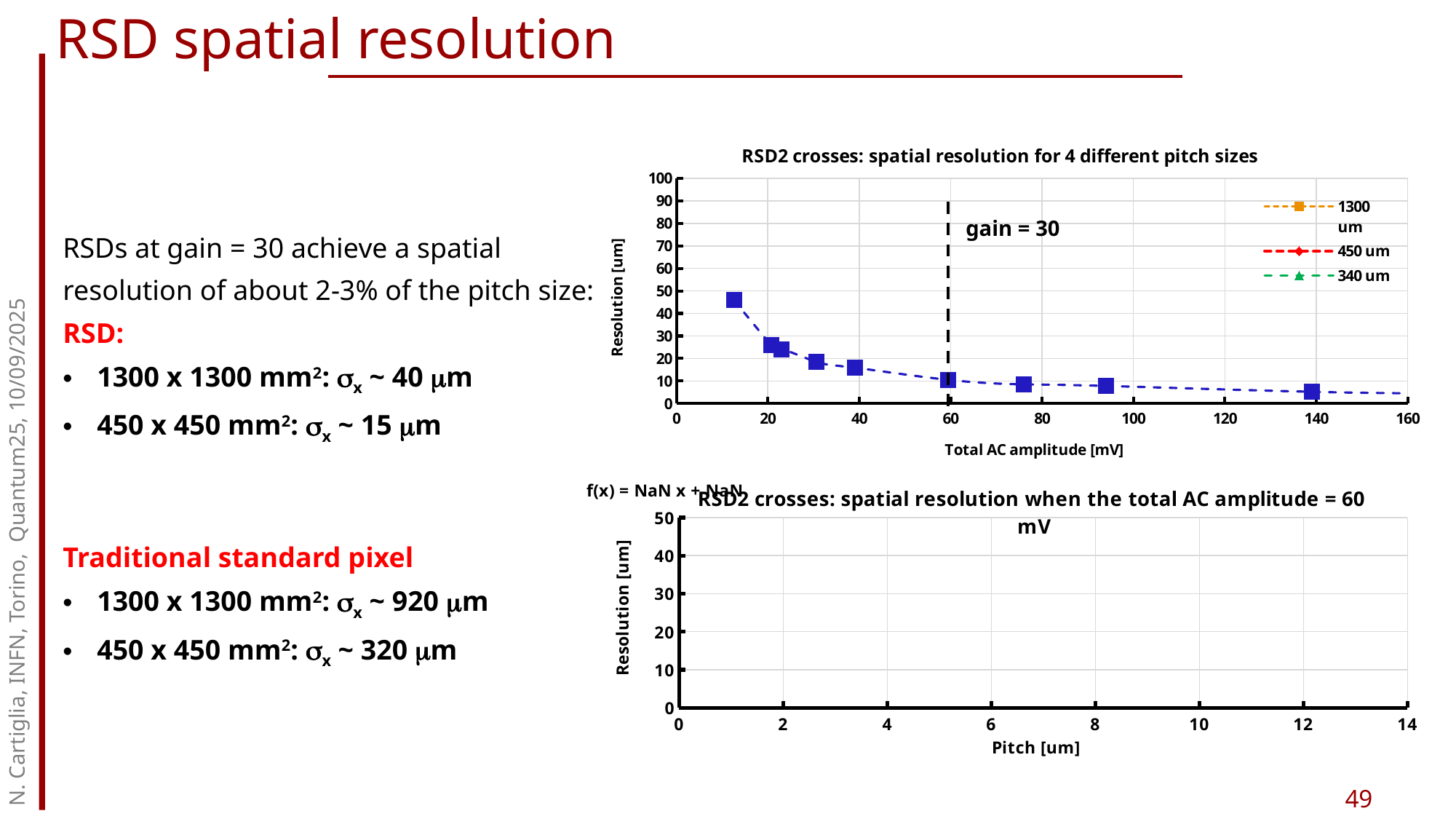
In the top chart, is the resolution at the lowest plotted amplitude (around 12 mV) greater or less than 40 um? greater What is the title of the top chart? RSD2 crosses: spatial resolution for 4 different pitch sizes What is the x-axis label of the bottom chart? Pitch [um] What kind of chart is the top chart? Scatter plot with a dashed trend line In the top chart, does the resolution rise or fall as the total AC amplitude increases? Fall In the top chart, which has the larger resolution: the point at about 12 mV or the point at about 140 mV? The point at about 12 mV In the top chart, what is the label of the x axis? Total AC amplitude [mV] In the top chart, is the resolution at the highest plotted amplitude (around 140 mV) greater or less than 10 um? less How many series does the legend of the top chart list? 3 In the top chart, at what total AC amplitude is the vertical dashed line labelled 'gain = 30' drawn? 60 mV In the top chart, is the resolution at about 40 mV greater or less than 20 um? less In the top chart, what is the maximum value shown on the y axis? 100